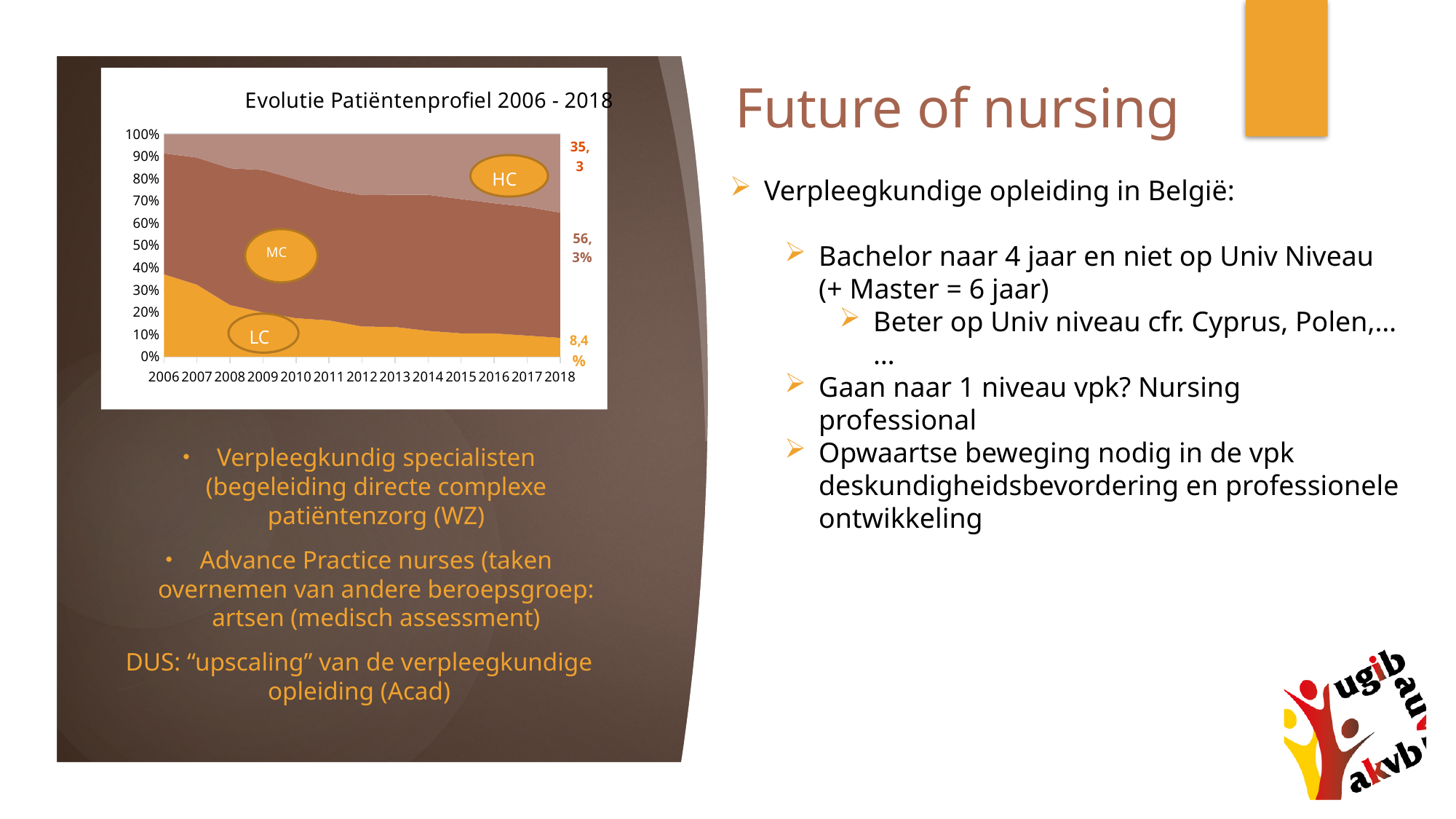
What is the title of the chart on the slide? Evolutie Patiëntenprofiel 2006 - 2018 What is the value labelled for MC in 2018? 56,3% What is the value labelled for HC in 2018? 35,3 Which series has the smallest share in 2018? LC In 2018, which is larger: the share of HC or the share of LC? HC How many series (LC, MC, HC) are plotted in the chart? 3 What kind of chart is shown on the slide? Stacked area chart How many years are shown along the x axis of the chart? 13 Which series has the largest share in 2018? MC Is the share of LC in 2006 greater or less than 30%? greater What is the value labelled for LC in 2018? 8,4% Does the share of LC rise or fall from 2006 to 2018? Fall